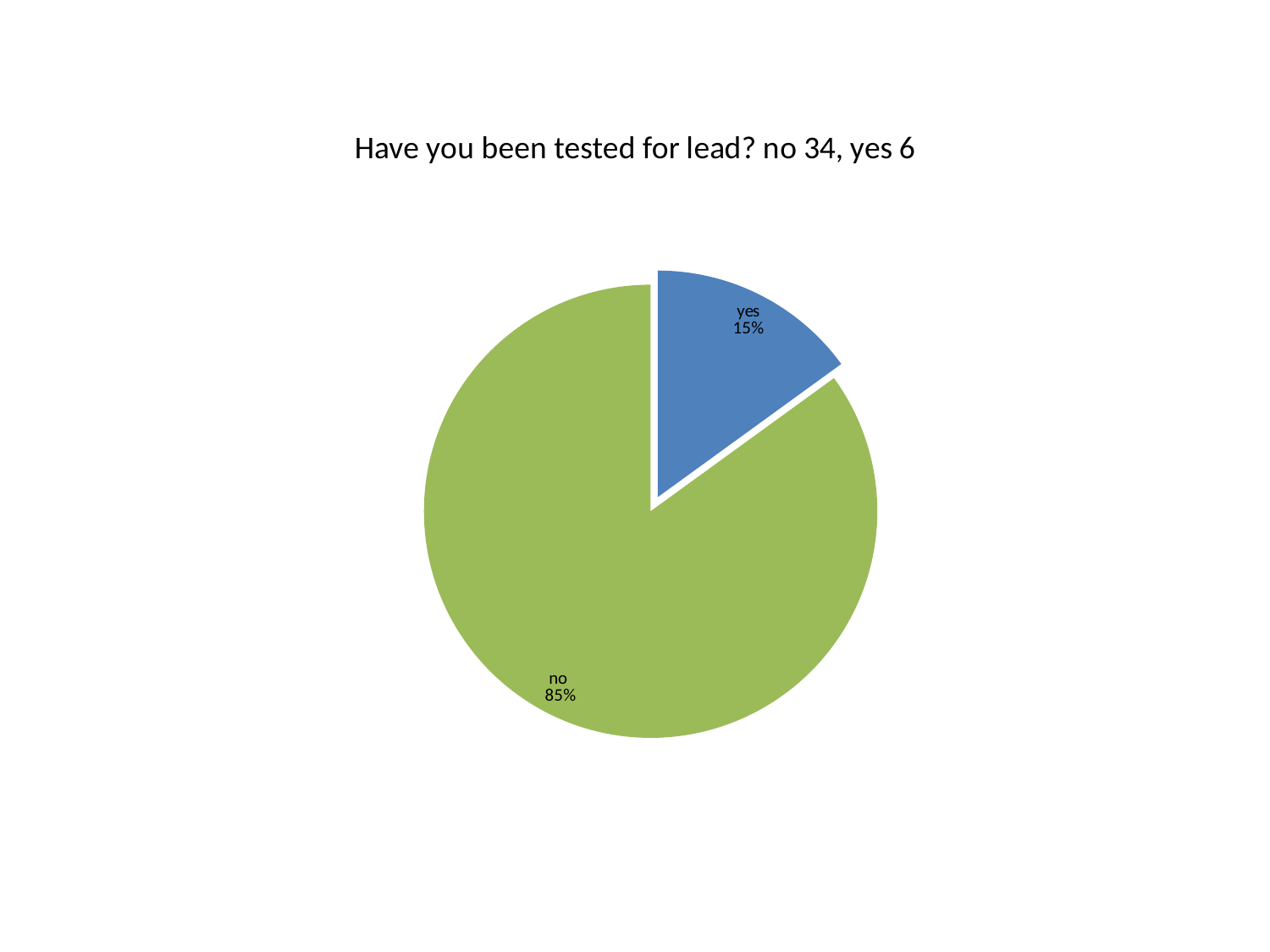
What kind of chart is shown on the slide? pie chart What is the title of the chart? Have you been tested for lead? no 34, yes 6 Which slice is the largest? no What share of the pie does the "no" slice represent? 85% According to the chart title, how many respondents answered "no"? 34 According to the chart title, how many respondents answered "yes"? 6 Which is larger, the "yes" slice or the "no" slice? no What colour is the "yes" slice? blue What share of the pie does the "yes" slice represent? 15% What is the difference in percentage points between the "no" and "yes" slices? 70 How many slices does the pie chart have? 2 Which slice is the smallest? yes